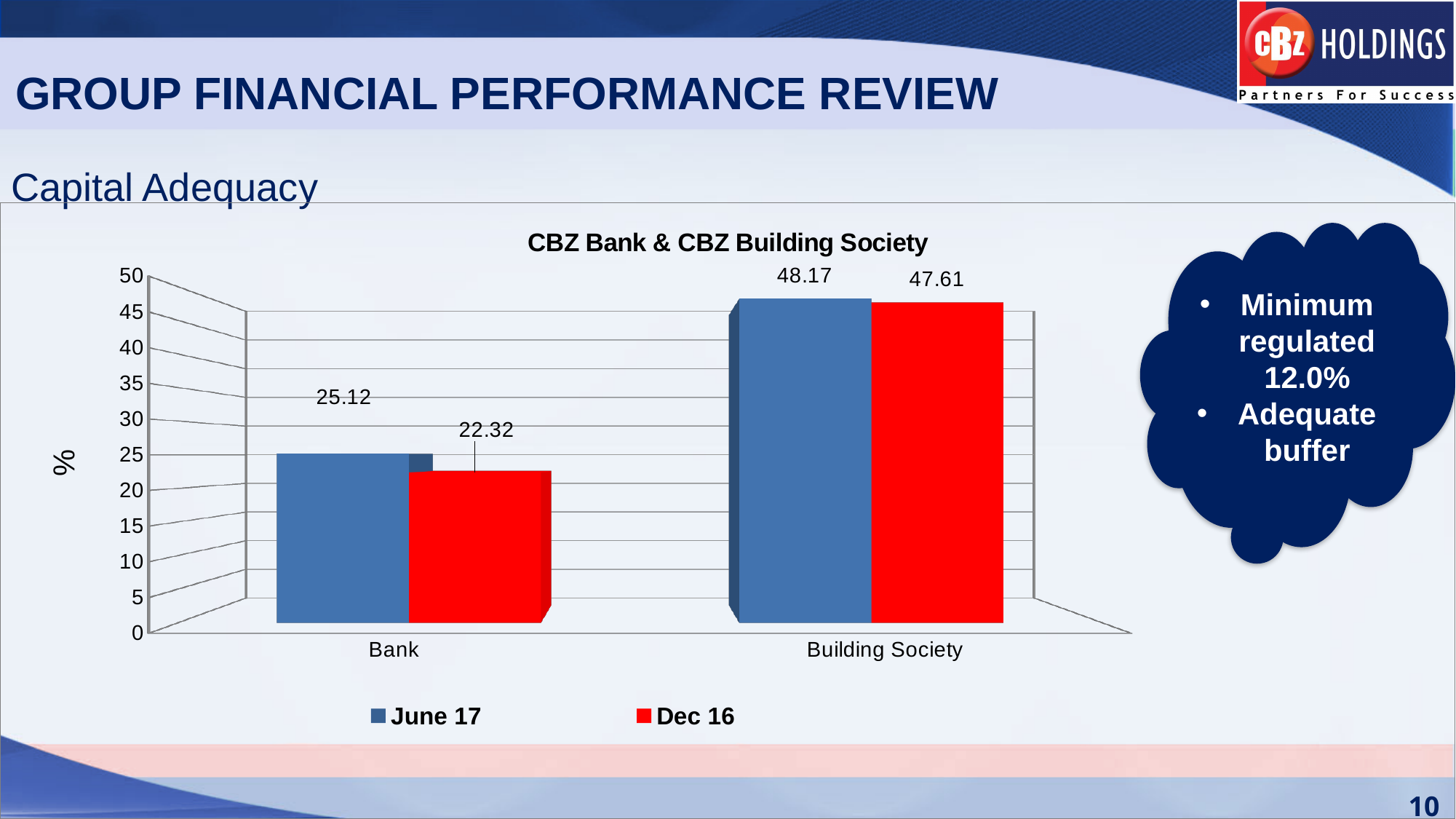
What is the title of the chart? CBZ Bank & CBZ Building Society What is the difference between the June 17 and Dec 16 values for Bank? 2.8 Which category has the lowest Dec 16 value? Bank How many series does the legend list? 2 How many categories are shown on the x axis? 2 What is the June 17 value for Bank? 25.12 What kind of chart is shown? Bar chart What is the Dec 16 value for Bank? 22.32 Which category has the highest June 17 value? Building Society Which is larger for Building Society, the June 17 value or the Dec 16 value? June 17 What is the Dec 16 value for Building Society? 47.61 What is the June 17 value for Building Society? 48.17